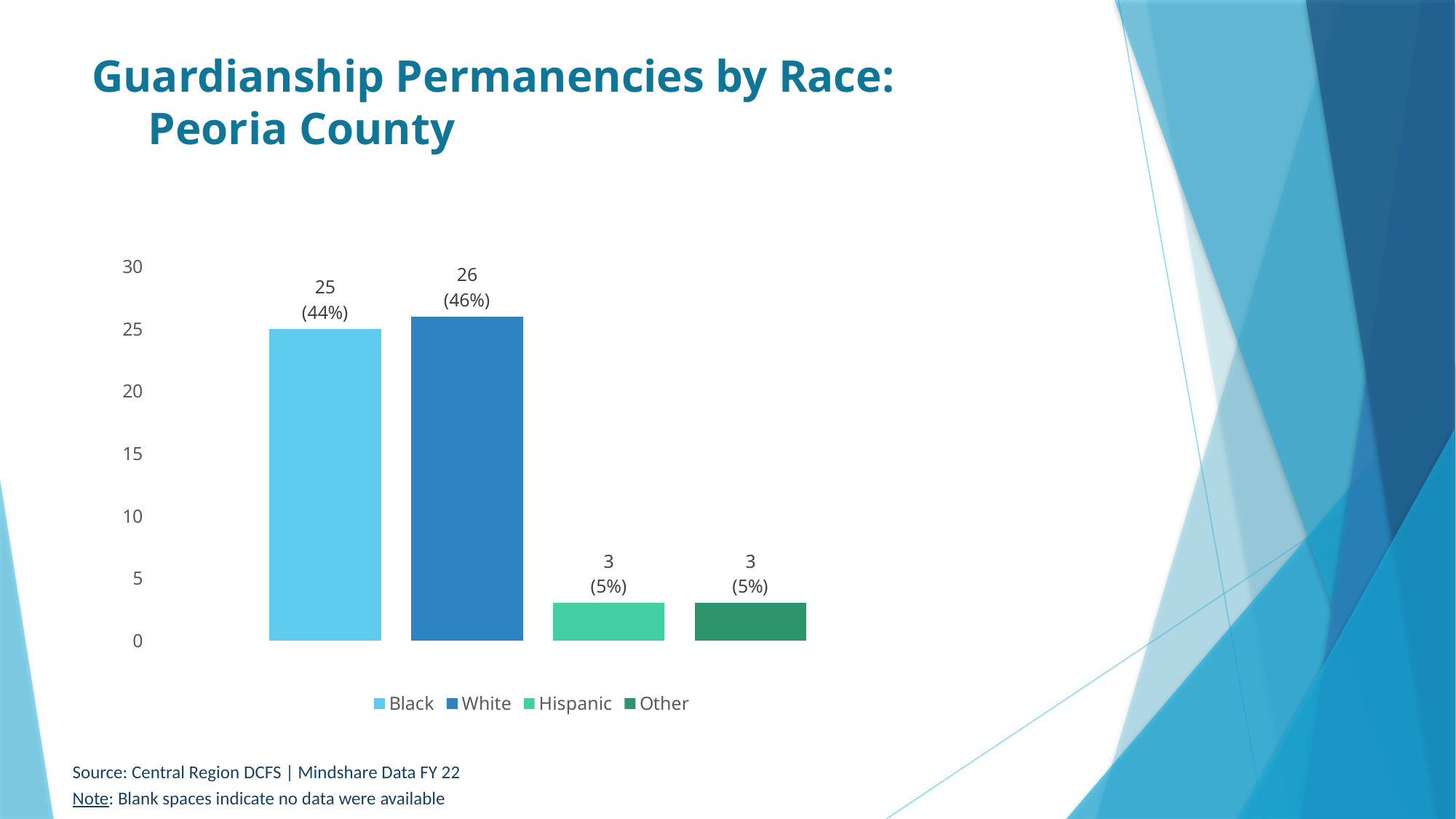
Which is larger, the value for Black or the value for Hispanic? Black How many guardianship permanencies are shown for Black in Peoria County? 25 Is the value for White greater or less than 20? greater What percentage of guardianship permanencies is shown for Black? 44% How many entries does the legend list? 4 What is the difference between the White and Black guardianship permanency counts? 1 How many guardianship permanencies are shown for Hispanic in Peoria County? 3 How many guardianship permanencies are shown for White in Peoria County? 26 What type of chart is shown on the slide? Bar chart How many race categories are plotted in the chart? 4 What percentage of guardianship permanencies is shown for Other? 5% Which race category has the highest number of guardianship permanencies? White